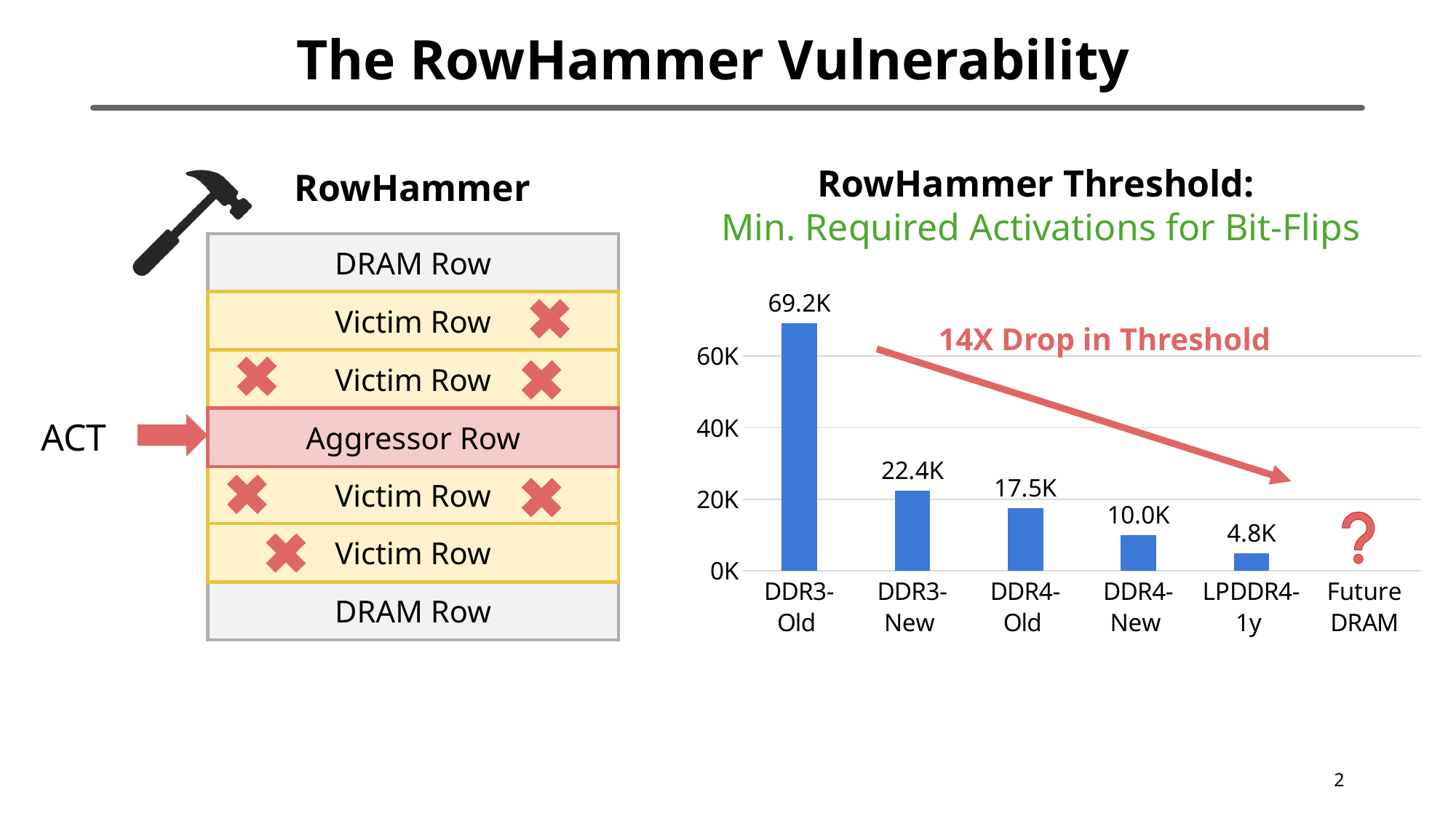
What is the RowHammer threshold value shown for DDR4-New? 10.0K Is the RowHammer threshold for DDR3-Old greater or less than 60K? greater What is the RowHammer threshold value shown for DDR3-New? 22.4K Do the RowHammer threshold values rise or fall from DDR3-Old to LPDDR4-1y? fall What is the difference between the RowHammer threshold of DDR3-New and DDR4-Old? 4.9K What is the RowHammer threshold value shown for DDR3-Old? 69.2K Among the DRAM types with a plotted bar, which has the lowest RowHammer threshold? LPDDR4-1y Which DRAM type has the highest RowHammer threshold in the chart? DDR3-Old Which has a larger RowHammer threshold, DDR4-Old or DDR4-New? DDR4-Old How many DRAM types have a plotted bar in the RowHammer Threshold chart? 5 What kind of chart is used to show the RowHammer Threshold? bar chart What is the RowHammer threshold value shown for LPDDR4-1y? 4.8K